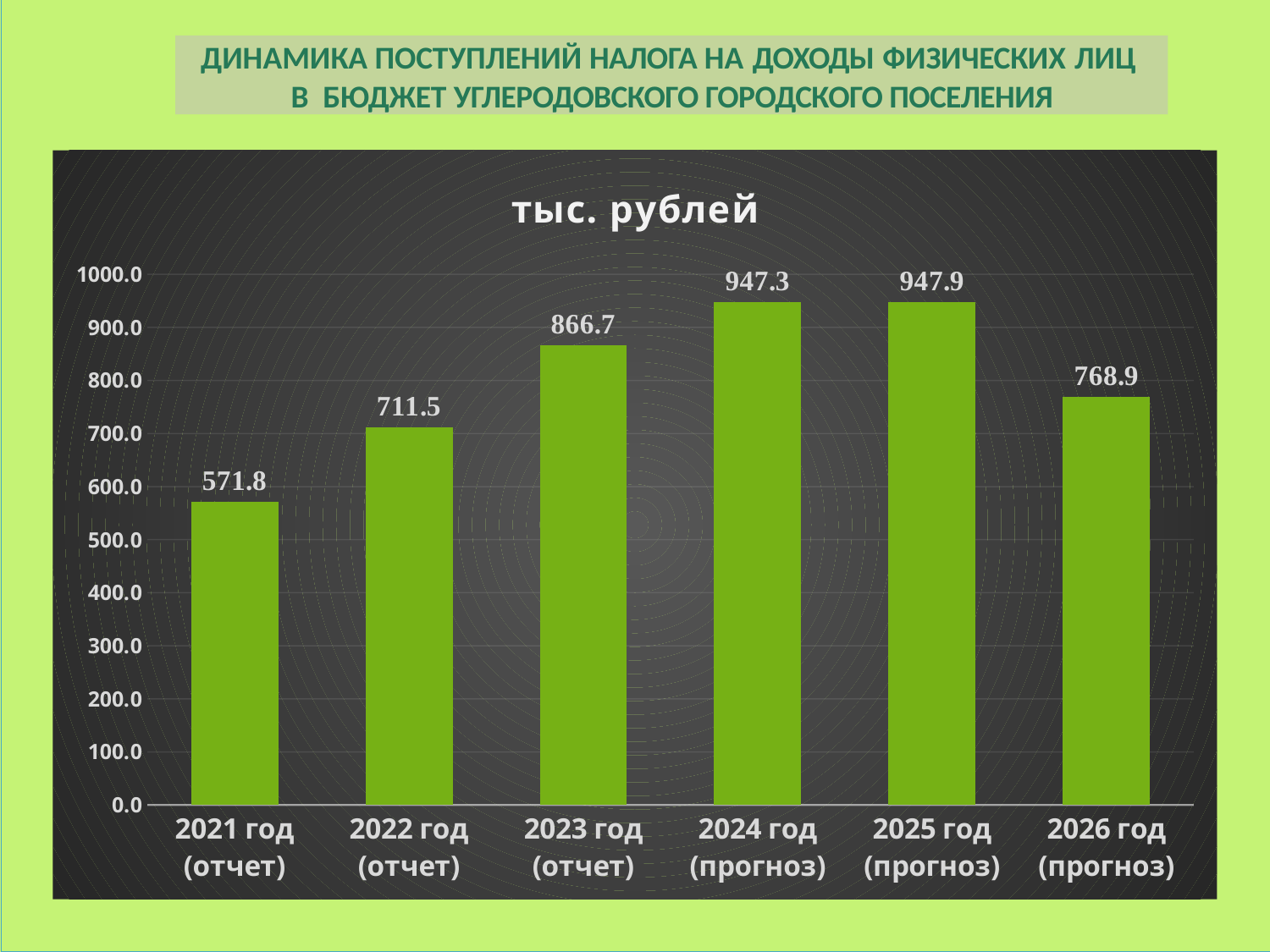
What is the value for 2026 год (прогноз)? 768.9 How many years are shown on the chart? 6 Do the values rise or fall from 2021 год (отчет) to 2024 год (прогноз)? rise What is the difference between the values for 2025 год (прогноз) and 2026 год (прогноз)? 179.0 What is the value for 2021 год (отчет)? 571.8 What is the difference between the values for 2023 год (отчет) and 2022 год (отчет)? 155.2 Which year has the lowest value? 2021 год (отчет) Is the value for 2021 год (отчет) greater or less than 600.0? less Which is larger, the value for 2022 год (отчет) or the value for 2026 год (прогноз)? 2026 год (прогноз) What kind of chart is shown on the slide? bar chart Which year has the highest value? 2025 год (прогноз) What is the value for 2024 год (прогноз)? 947.3